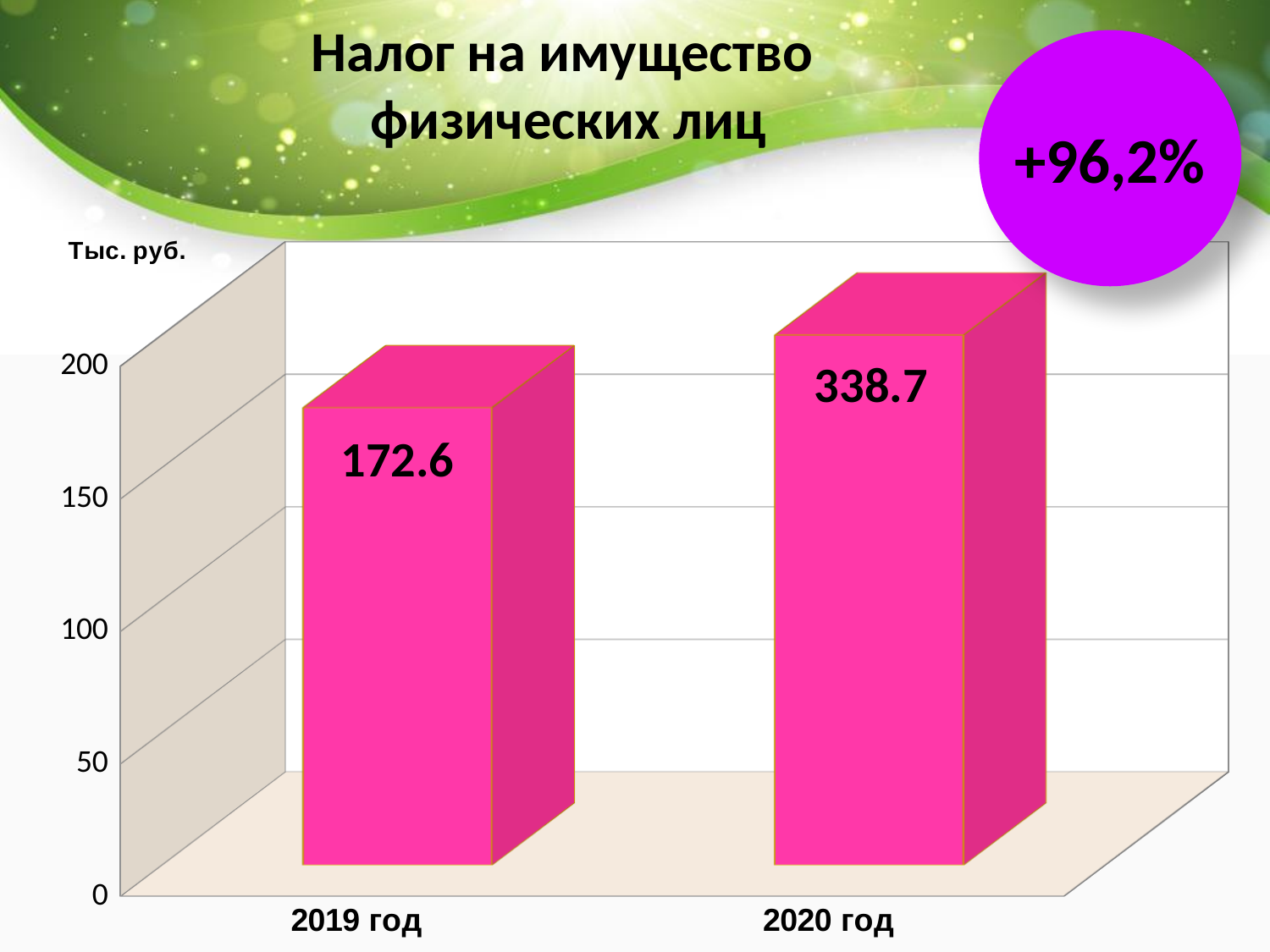
Is the value for 2020 год larger or smaller than the value for 2019 год? larger What unit is shown on the vertical axis label? Тыс. руб. Which year has the lower value? 2019 год What is the difference between the values for 2020 год and 2019 год? 166.1 What is the value for 2020 год? 338.7 Do the values rise or fall from 2019 год to 2020 год? rise What is the value for 2019 год? 172.6 What is the title of the slide? Налог на имущество физических лиц How many bars are shown in the chart? 2 What kind of chart is shown on the slide? bar chart Which year has the higher value? 2020 год